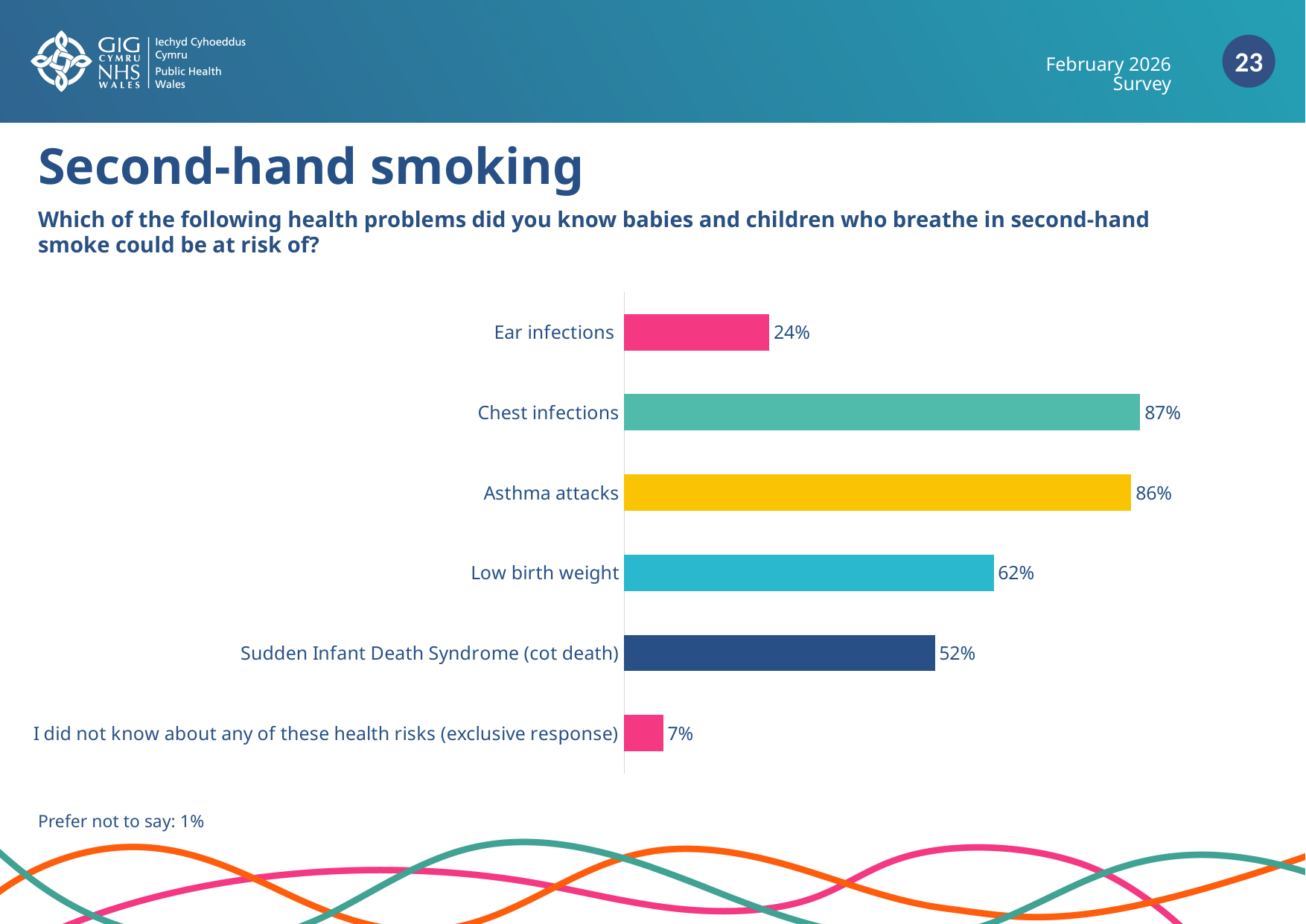
How many bars are shown in the chart? 6 What percentage is shown for Sudden Infant Death Syndrome (cot death)? 52% What is the difference between the values for Chest infections and Asthma attacks? 1% What percentage of respondents knew about ear infections as a risk of second-hand smoke? 24% What is the difference between the values for Low birth weight and Sudden Infant Death Syndrome (cot death)? 10% Which is larger, the value for Ear infections or the value for Low birth weight? Low birth weight What percentage of respondents did not know about any of these health risks? 7% What percentage is given for 'Prefer not to say' below the chart? 1% What type of chart is shown on the slide? Bar chart What is the value shown for Low birth weight? 62% Which health problem has the highest percentage? Chest infections Which bar has the lowest value? I did not know about any of these health risks (exclusive response)